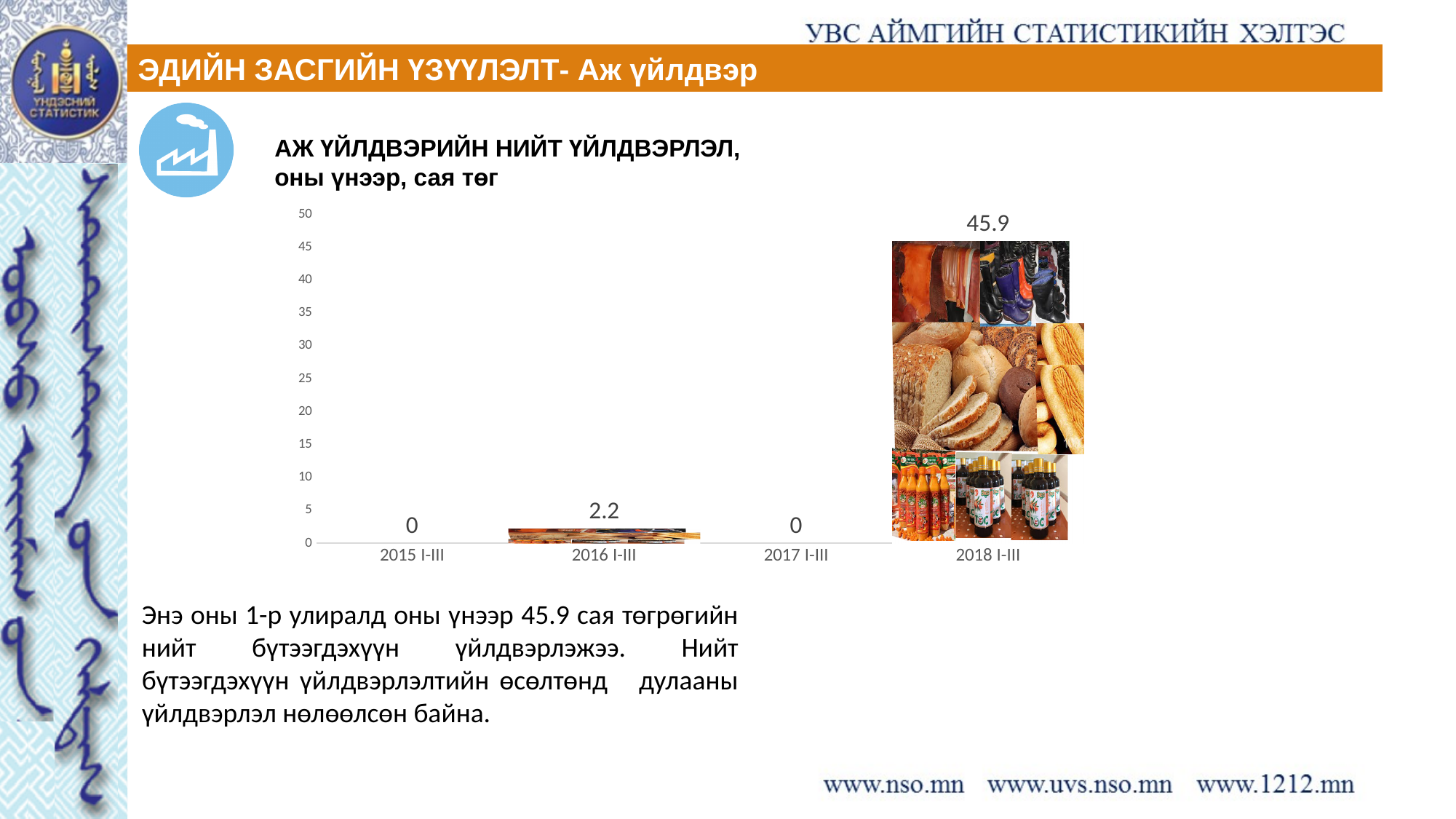
What is the value for 2015 I-III? 0 What is the difference between the values for 2018 I-III and 2016 I-III? 43.7 What is the value for 2016 I-III? 2.2 What is the value for 2018 I-III? 45.9 What is the value for 2017 I-III? 0 Which period has the highest value? 2018 I-III How many periods are shown on the x axis? 4 Which is larger, the value for 2016 I-III or the value for 2018 I-III? 2018 I-III What unit is stated in the chart title? сая төг What is the highest tick value on the y axis? 50 Is the value for 2018 I-III greater or less than 40? greater What kind of chart is shown on the slide? bar chart